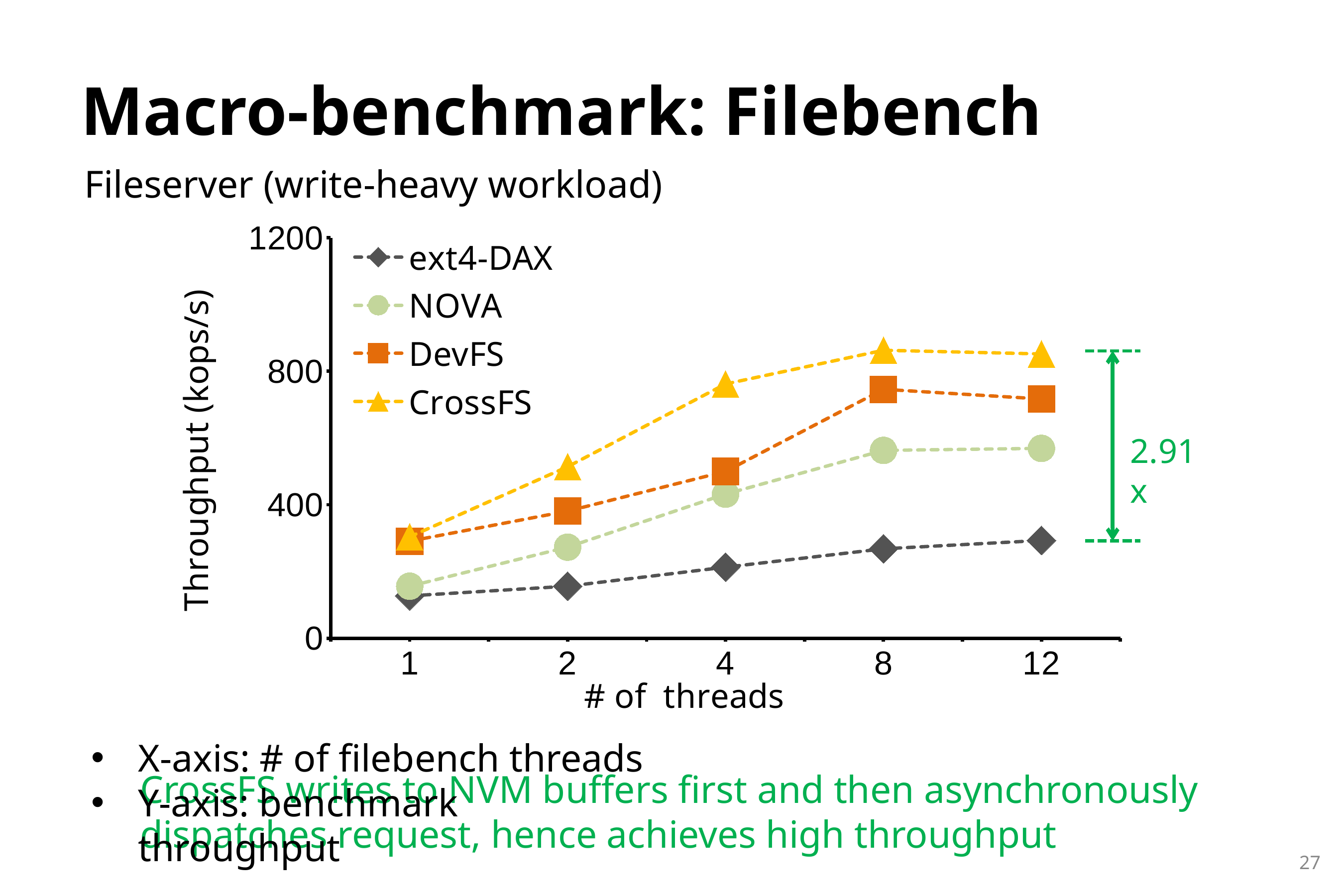
What kind of chart is shown on the slide? line chart How many thread counts are plotted along the x axis? 5 What speedup factor is annotated between CrossFS and ext4-DAX at 12 threads? 2.91x Does the throughput of ext4-DAX rise or fall as the number of threads increases? rise Is the throughput for DevFS at 8 threads greater or less than 800? less Which file system has the lowest throughput at 8 threads? ext4-DAX At 4 threads, which has higher throughput, CrossFS or NOVA? CrossFS Is the throughput for NOVA at 12 threads greater or less than 400? greater How many series does the legend list? 4 Which file system has the highest throughput at 12 threads? CrossFS Is the throughput for ext4-DAX at 12 threads greater or less than 400? less